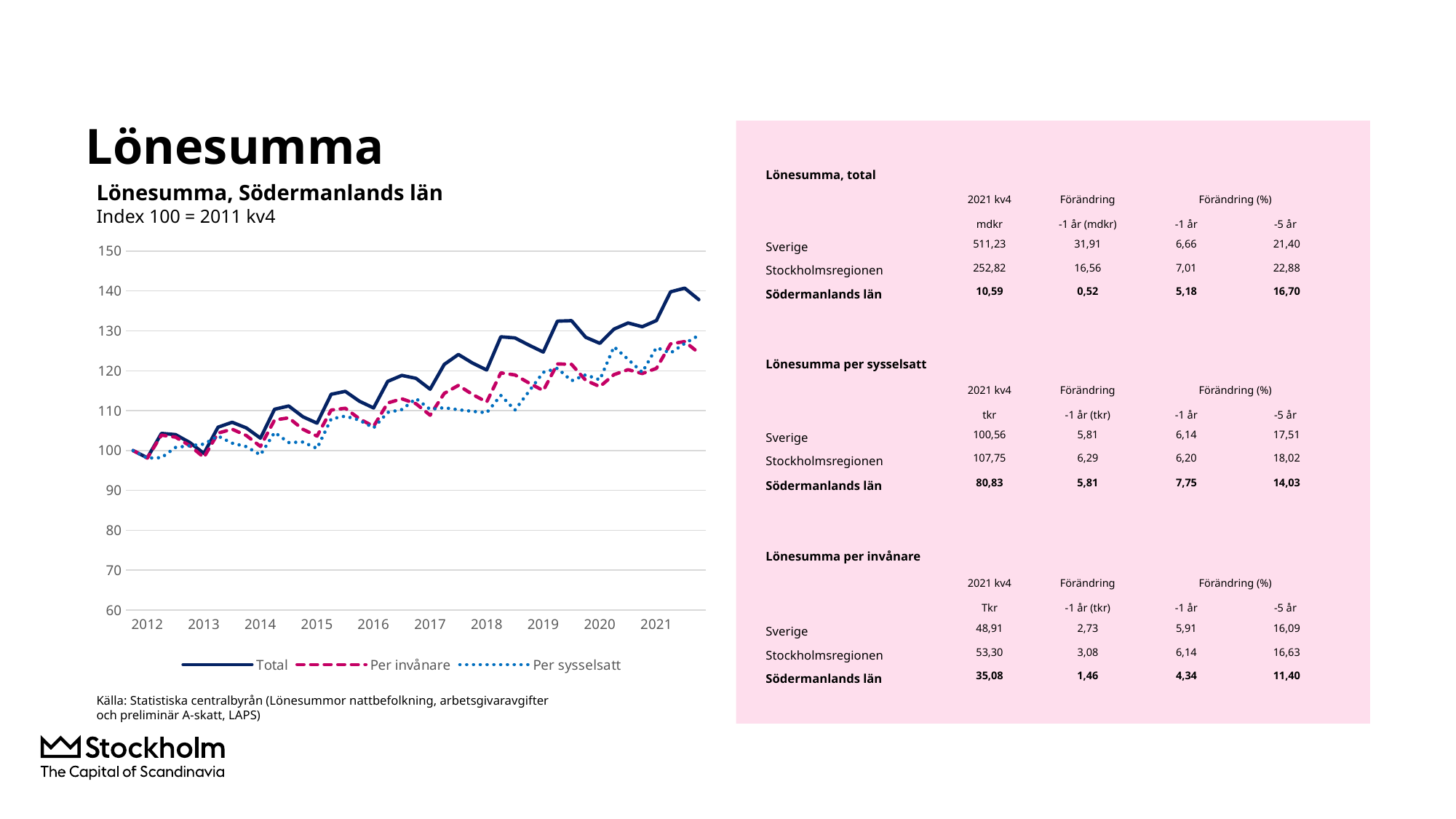
Does the Total series rise or fall from 2012 to 2021? Rise Which series reaches the highest value on the chart? Total Is the value of the Per invånare series at the end of 2021 greater or less than 120? greater What are the three series listed in the chart's legend? Total, Per invånare, Per sysselsatt At the end of 2021, which series is higher: Total or Per invånare? Total Is the value of the Total series at the start of 2018 greater or less than 130? less What is the title of the chart? Lönesumma, Södermanlands län How many series does the chart's legend list? 3 Is the value of the Total series at the end of 2021 greater or less than 130? greater What kind of chart is shown on the slide? Line chart